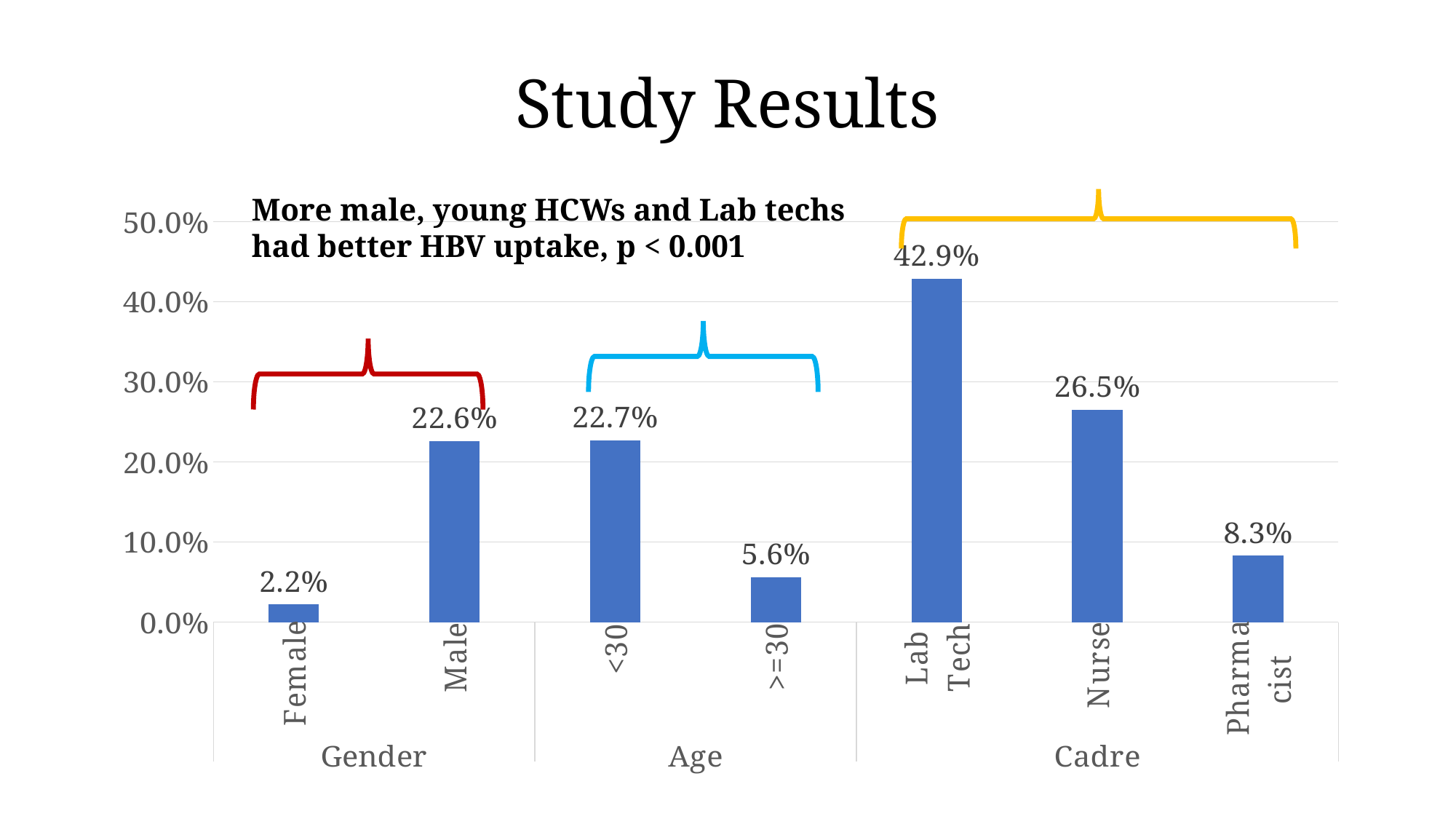
What are the three group labels shown along the x axis? Gender, Age, Cadre What kind of chart is shown on the slide? bar chart How many bars are plotted in the chart? 7 What is the difference between the values for Lab Tech and Nurse? 16.4% What is the difference between the values for Male and Female? 20.4% Which category has the highest value? Lab Tech What is the value for Female? 2.2% Which is larger, the value for Nurse or the value for Pharmacist? Nurse What is the value for >=30? 5.6% Which category has the lowest value? Female Is the value for Nurse greater or less than 20.0%? greater What is the value for Lab Tech? 42.9%